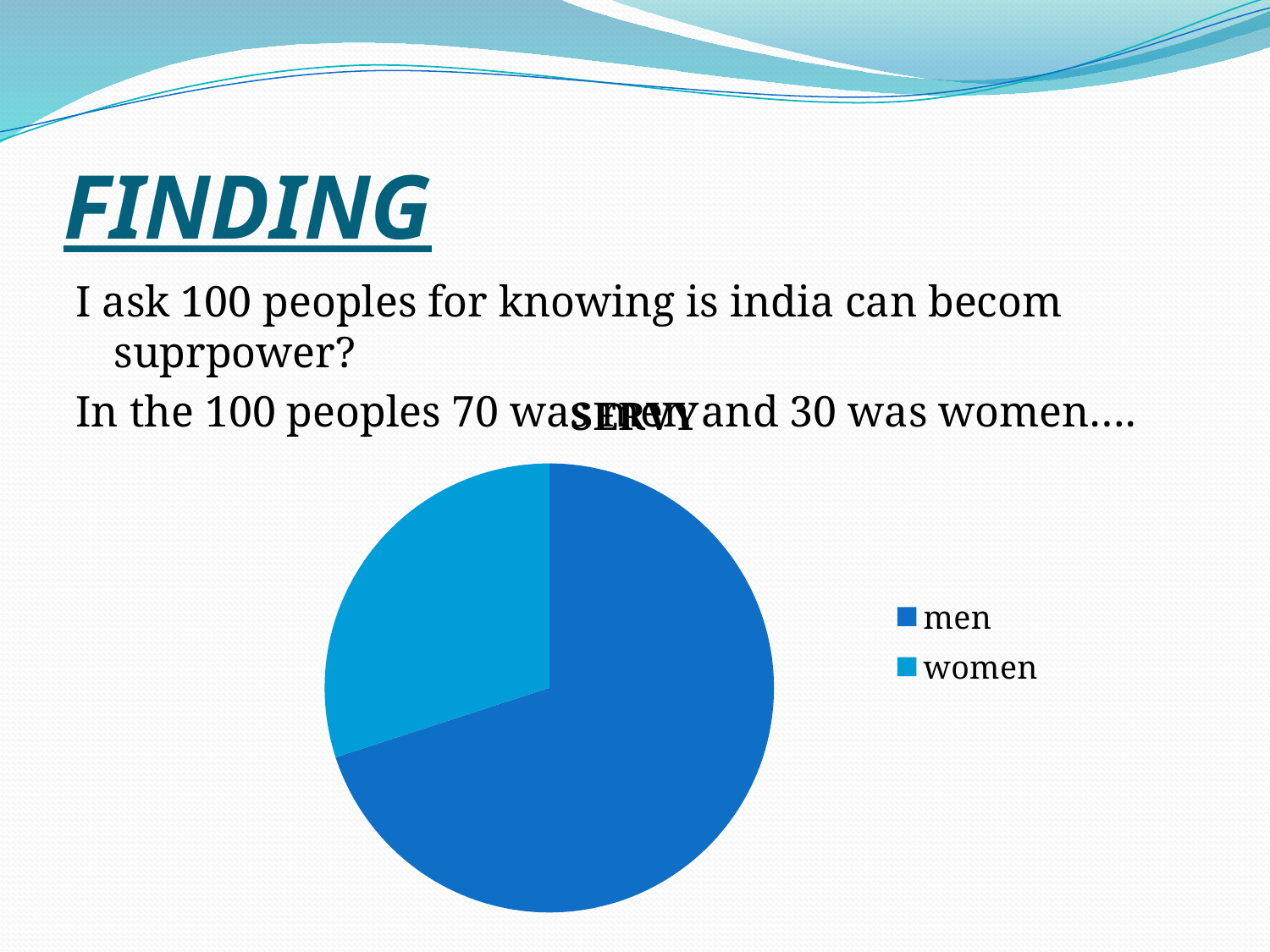
What kind of chart is shown on the slide? pie chart What are the two categories listed in the legend of the pie chart? men and women Does the men slice take up more or less than half of the pie chart? more Does the women slice take up more or less than half of the pie chart? less Which category has the smallest slice in the pie chart? women Which legend entry is shown in the lighter blue colour in the pie chart? women Which category has the largest slice in the pie chart? men Which slice is larger in the pie chart, men or women? men How many entries does the legend of the pie chart list? 2 How many slices does the pie chart have? 2